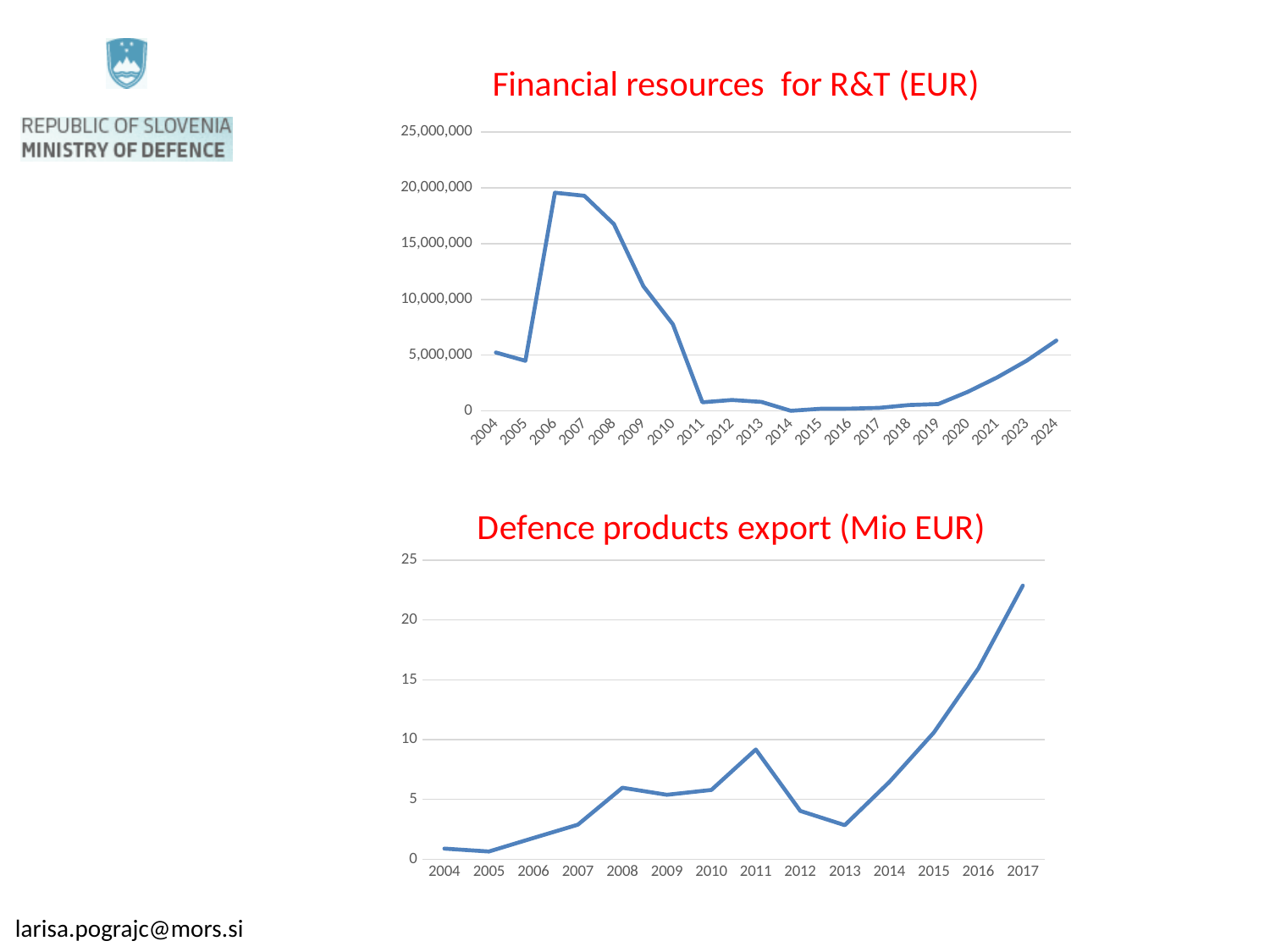
What kind of chart is the 'Defence products export (Mio EUR)' chart? line chart In the 'Defence products export (Mio EUR)' chart, is the value for 2013 greater or less than 5? less In the 'Defence products export (Mio EUR)' chart, how many years are shown on the x axis? 14 In the 'Financial resources for R&T (EUR)' chart, which year has the larger value, 2006 or 2011? 2006 In the 'Defence products export (Mio EUR)' chart, is the value for 2017 greater or less than 20? greater In the 'Defence products export (Mio EUR)' chart, do the values rise or fall from 2013 to 2017? rise In the 'Financial resources for R&T (EUR)' chart, how many years are labelled on the x axis? 20 In the 'Financial resources for R&T (EUR)' chart, is the value for 2006 greater or less than 15,000,000? greater In the 'Financial resources for R&T (EUR)' chart, do the values rise or fall from 2007 to 2011? fall What kind of chart is the 'Financial resources for R&T (EUR)' chart? line chart In the 'Defence products export (Mio EUR)' chart, which year has the highest value? 2017